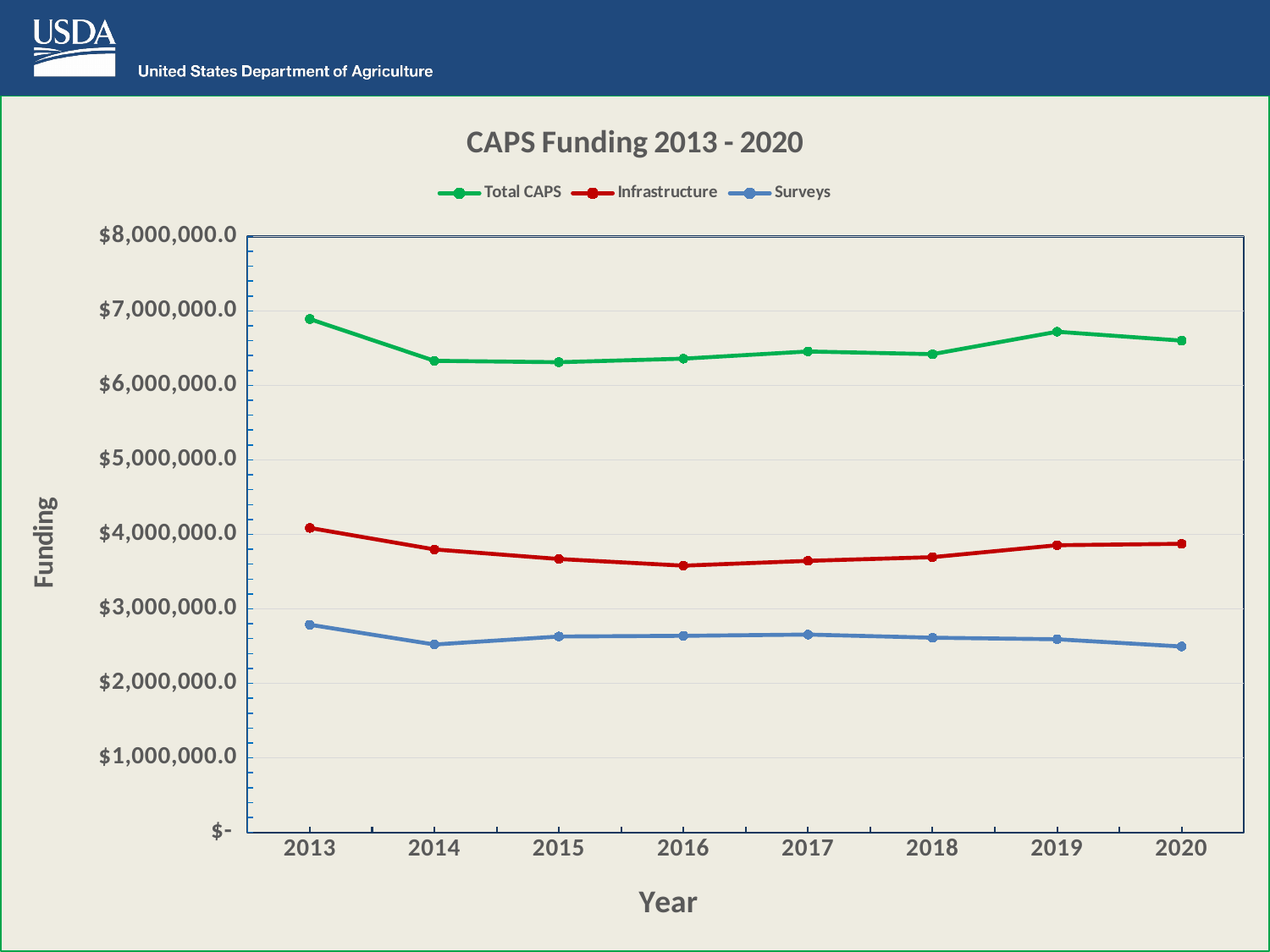
Is the Total CAPS value for 2019 greater or less than $7,000,000.0? less What kind of chart is shown on the slide? Line chart Does the Total CAPS line rise or fall from 2013 to 2014? Fall Which year has the highest Infrastructure funding? 2013 Is the Surveys value for 2014 greater or less than $3,000,000.0? less Which year has the highest Surveys funding? 2013 Is the Infrastructure value for 2016 greater or less than $4,000,000.0? less In 2020, which series has the larger value, Infrastructure or Surveys? Infrastructure What is the title of the chart? CAPS Funding 2013 - 2020 How many years are plotted along the x axis? 8 Which year has the highest Total CAPS funding? 2013 How many series does the legend list? 3